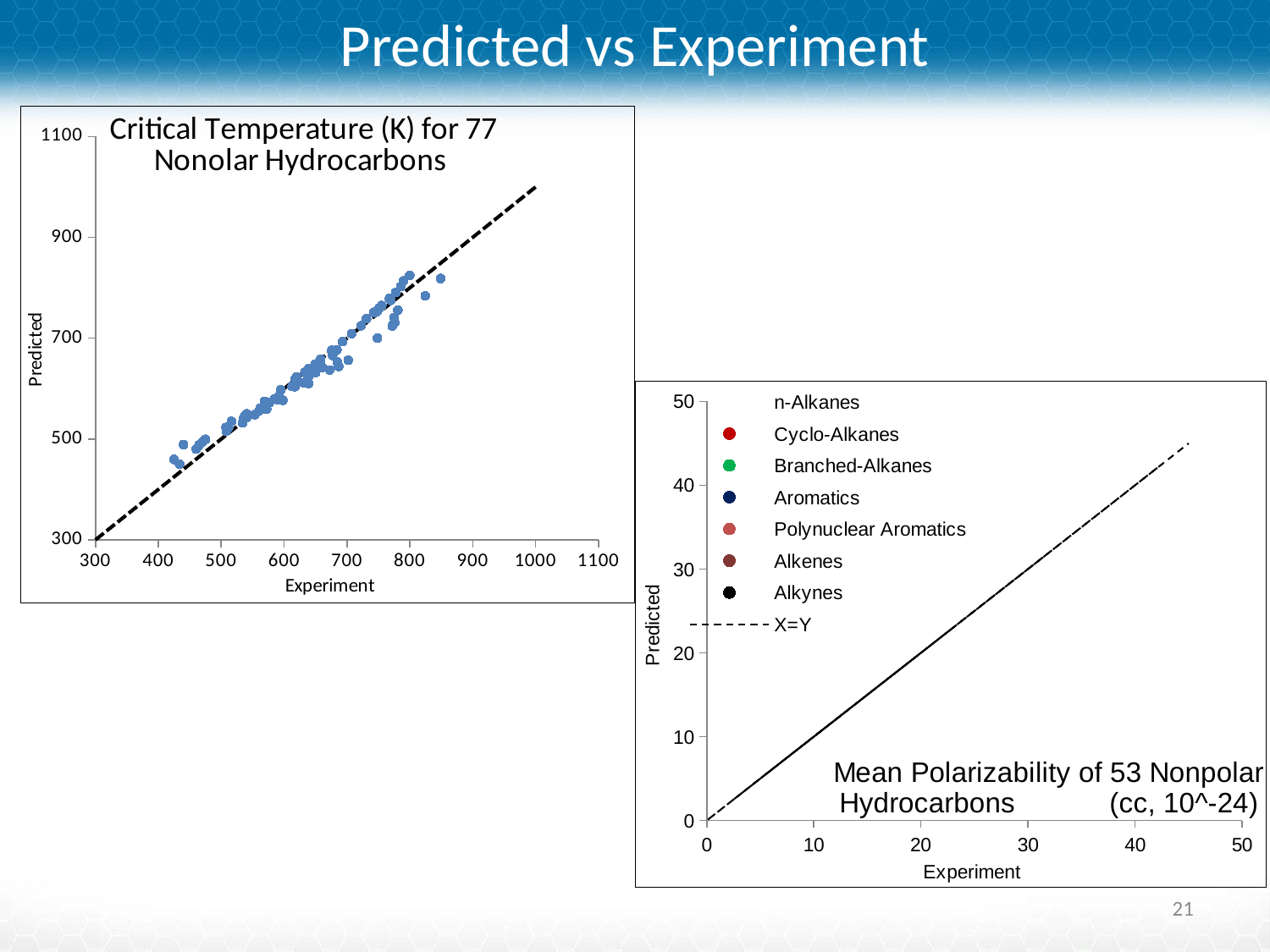
In the right chart (Mean Polarizability), what does the dashed line in the legend represent? X=Y What kind of chart is the left chart titled "Critical Temperature (K) for 77 Nonolar Hydrocarbons"? Scatter chart What is the lowest tick value shown on the x axis of the left chart (Critical Temperature)? 300 What is the label of the y axis on the right chart (Mean Polarizability)? Predicted How many entries does the legend of the right chart (Mean Polarizability) list? 8 How many hydrocarbons does the title of the right chart say are included? 53 What kind of chart is the right chart titled "Mean Polarizability of 53 Nonpolar Hydrocarbons"? Scatter chart What is the highest tick value shown on the x axis of the right chart (Mean Polarizability)? 50 What is the highest tick value shown on the y axis of the left chart (Critical Temperature)? 1100 In the left chart (Critical Temperature), do the plotted points rise or fall as the Experiment value increases? Rise What is the label of the x axis on the left chart (Critical Temperature)? Experiment How many hydrocarbons does the title of the left chart say are included? 77